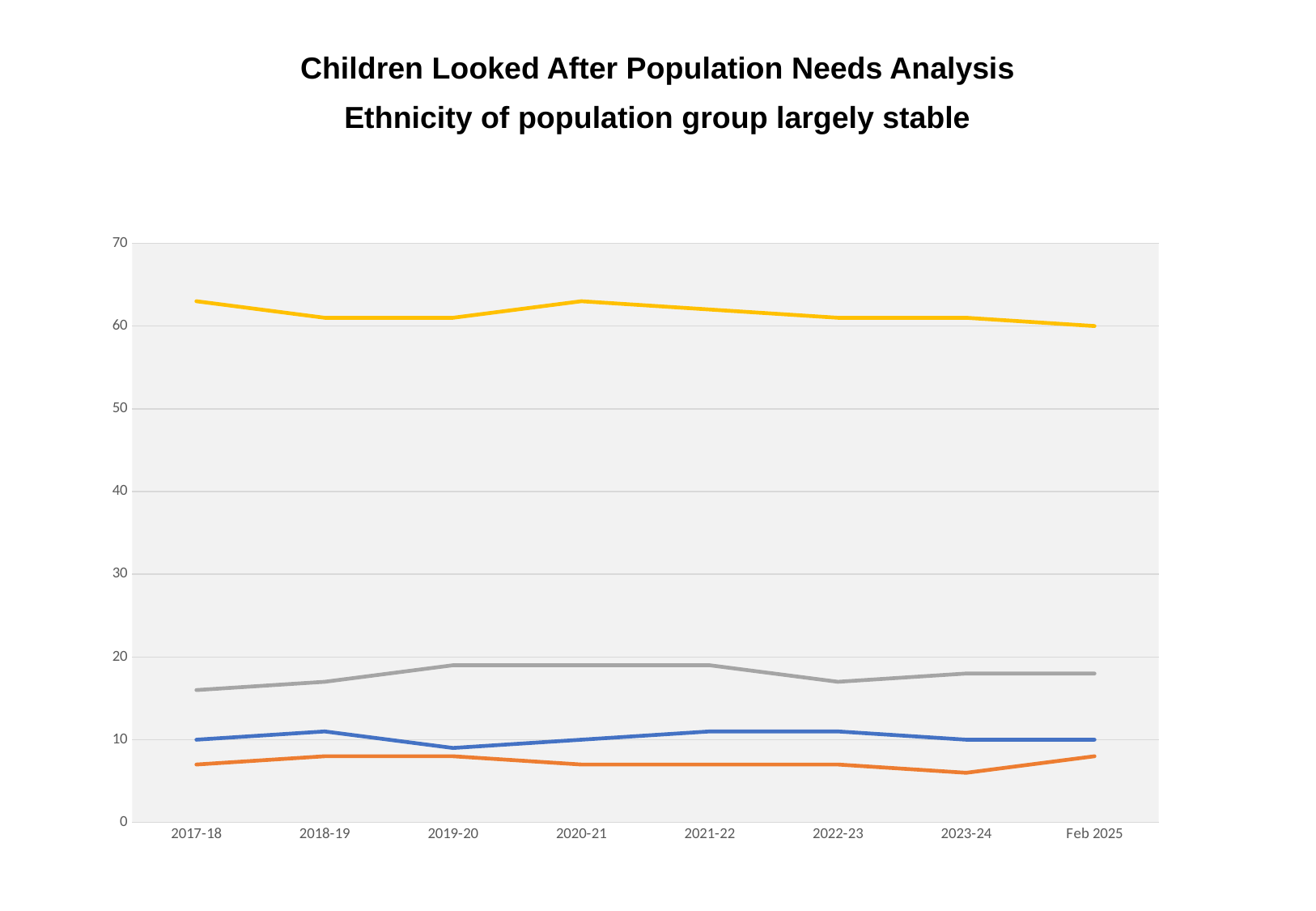
Is the value of the orange line for 2023-24 greater or less than 10? less Which line has the lowest values across the whole chart? orange line Which line has the highest values across the whole chart? yellow line At 2020-21, which line has the larger value, the yellow line or the grey line? yellow line At 2021-22, which line has the larger value, the grey line or the blue line? grey line Does the yellow line rise or fall from 2020-21 to Feb 2025? fall What is the label of the last point on the x axis? Feb 2025 How many time periods are shown along the x axis? 8 What kind of chart is shown on the slide? line chart Is the value of the grey line for 2017-18 greater or less than 10? greater Is the value of the grey line for 2019-20 greater or less than 20? less